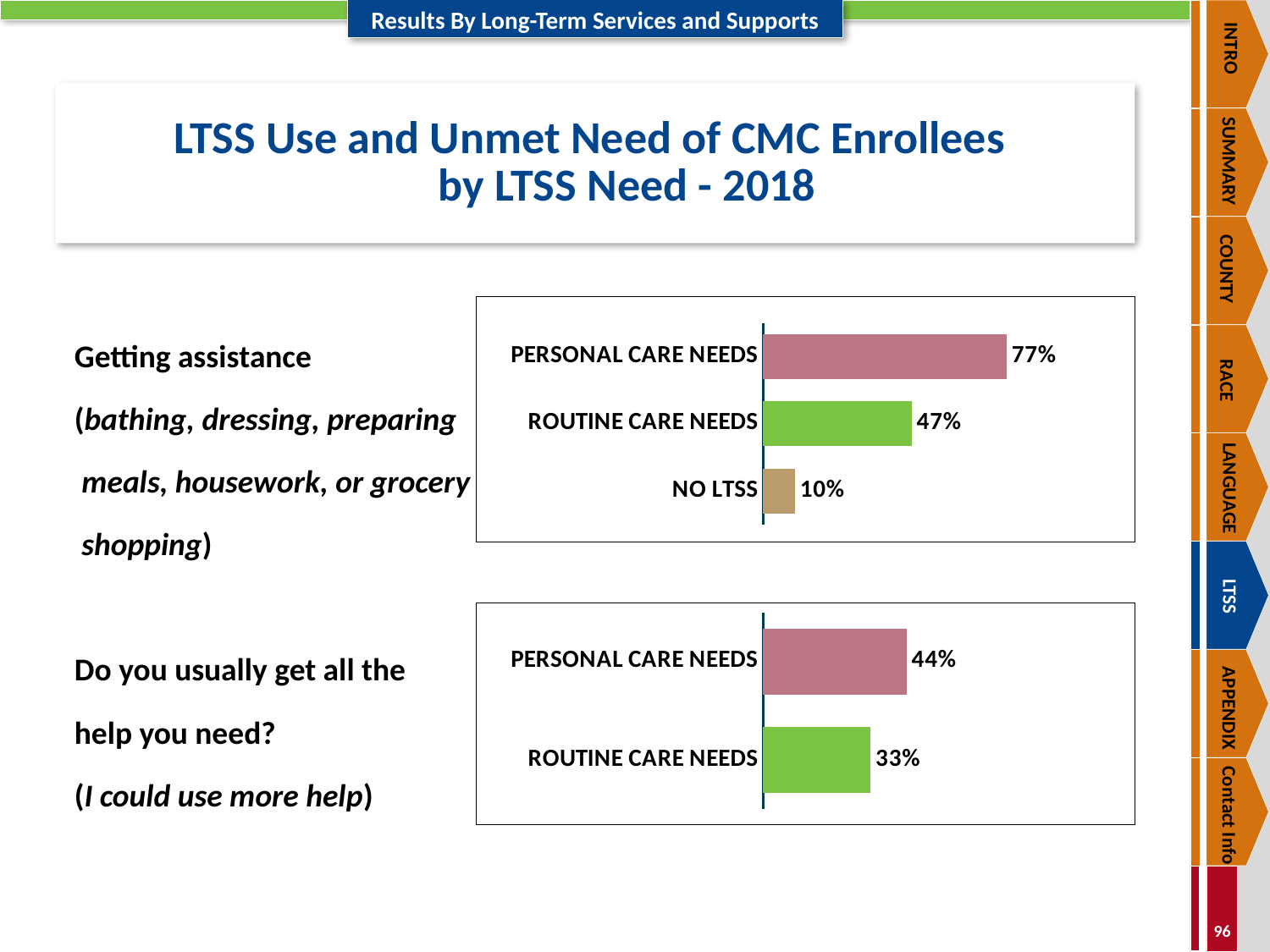
In the top chart (Getting assistance), how many categories are shown? 3 What kind of chart is the bottom chart (Do you usually get all the help you need?)? Bar chart In the top chart (Getting assistance), what is the value for ROUTINE CARE NEEDS? 47% In the top chart (Getting assistance), what is the difference between PERSONAL CARE NEEDS and ROUTINE CARE NEEDS? 30% In the top chart (Getting assistance), what is the value for NO LTSS? 10% In the bottom chart (Do you usually get all the help you need?), what is the difference between PERSONAL CARE NEEDS and ROUTINE CARE NEEDS? 11% In the bottom chart (Do you usually get all the help you need?), which is larger, PERSONAL CARE NEEDS or ROUTINE CARE NEEDS? PERSONAL CARE NEEDS In the top chart (Getting assistance), which category has the highest value? PERSONAL CARE NEEDS In the top chart (Getting assistance), what is the value for PERSONAL CARE NEEDS? 77% In the top chart (Getting assistance), which category has the lowest value? NO LTSS In the bottom chart (Do you usually get all the help you need?), what is the value for PERSONAL CARE NEEDS? 44% In the bottom chart (Do you usually get all the help you need?), what is the value for ROUTINE CARE NEEDS? 33%